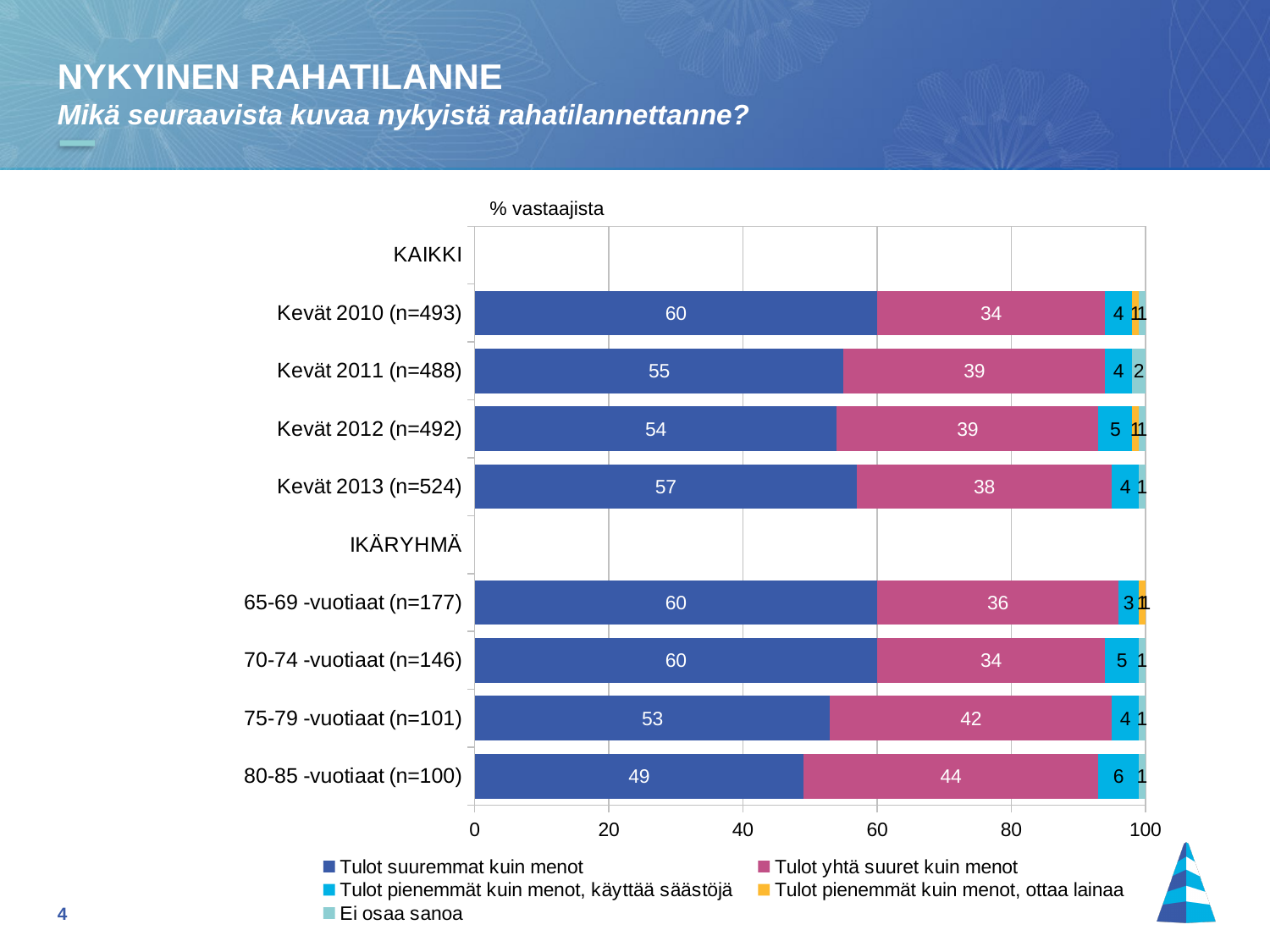
Which category has the highest value for "Tulot yhtä suuret kuin menot"? 80-85 -vuotiaat (n=100) Is the "Tulot suuremmat kuin menot" value for 70-74 -vuotiaat (n=146) greater or less than 40? greater What kind of chart is shown on the slide? stacked bar chart What is the value of "Tulot yhtä suuret kuin menot" for 75-79 -vuotiaat (n=101)? 42 How many series does the legend list? 5 What is the value of "Tulot pienemmät kuin menot, käyttää säästöjä" for 80-85 -vuotiaat (n=100)? 6 Which is larger: the "Tulot yhtä suuret kuin menot" value for Kevät 2012 (n=492) or for 65-69 -vuotiaat (n=177)? Kevät 2012 (n=492) Which category has the lowest value for "Tulot suuremmat kuin menot"? 80-85 -vuotiaat (n=100) What is the value of "Tulot suuremmat kuin menot" for Kevät 2013 (n=524)? 57 What is the difference between the "Tulot suuremmat kuin menot" values for Kevät 2010 (n=493) and Kevät 2011 (n=488)? 5 How many bars are plotted in the chart? 8 What is the label shown above the chart indicating the unit of the values? % vastaajista